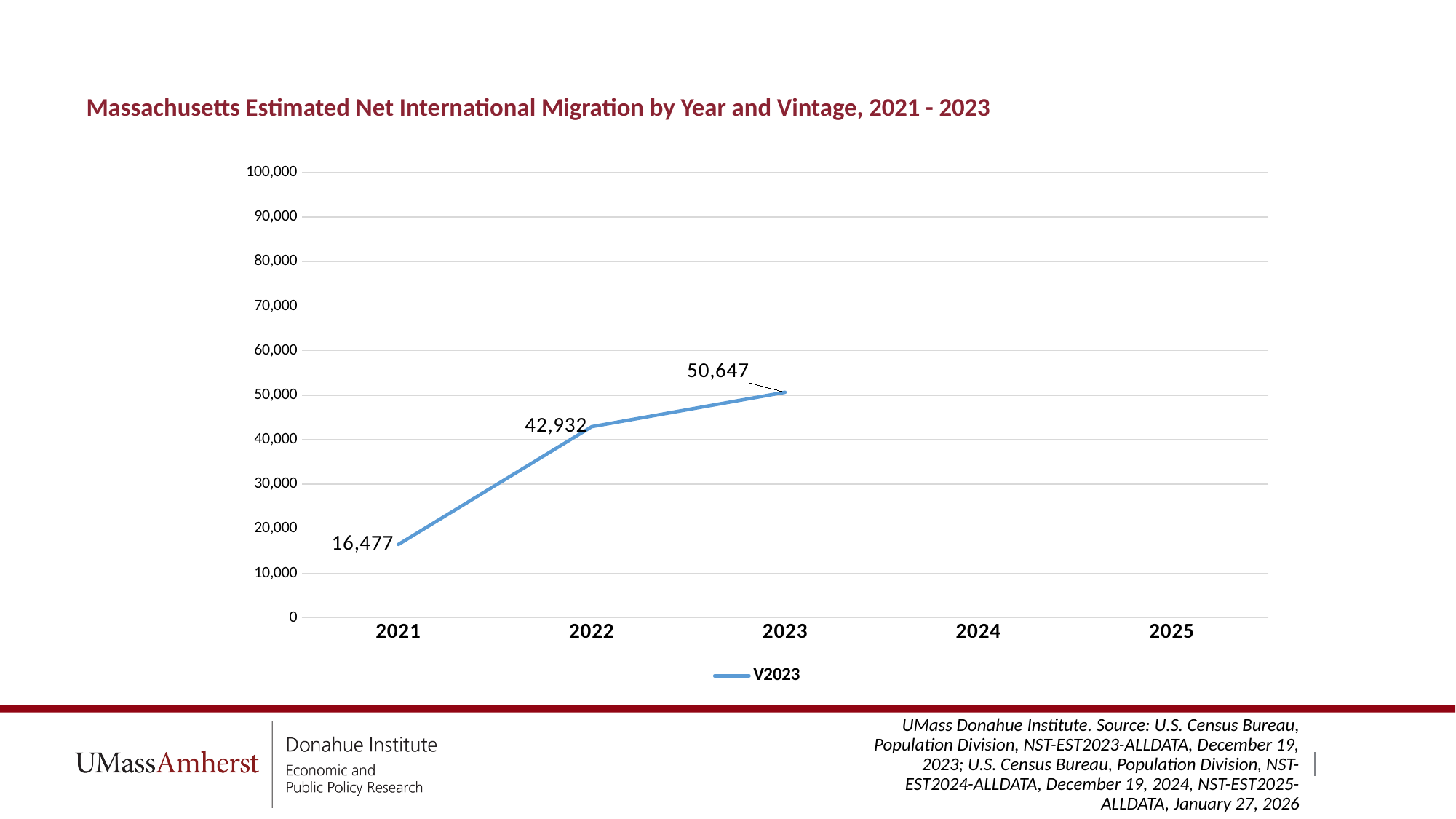
Is the value for 2023 greater or less than 50,000? greater What is the estimated net international migration for 2022? 42,932 What is the difference between the 2022 value and the 2021 value? 26,455 Which is larger, the value for 2021 or the value for 2022? 2022 What kind of chart is shown on the slide? Line chart What is the estimated net international migration for 2023? 50,647 Which year has the highest plotted value? 2023 How many data points are plotted on the line? 3 Which year has the lowest plotted value? 2021 What is the estimated net international migration for 2021 in the V2023 series? 16,477 What is the difference between the 2023 value and the 2022 value? 7,715 Do the plotted values rise or fall from 2021 to 2023? Rise